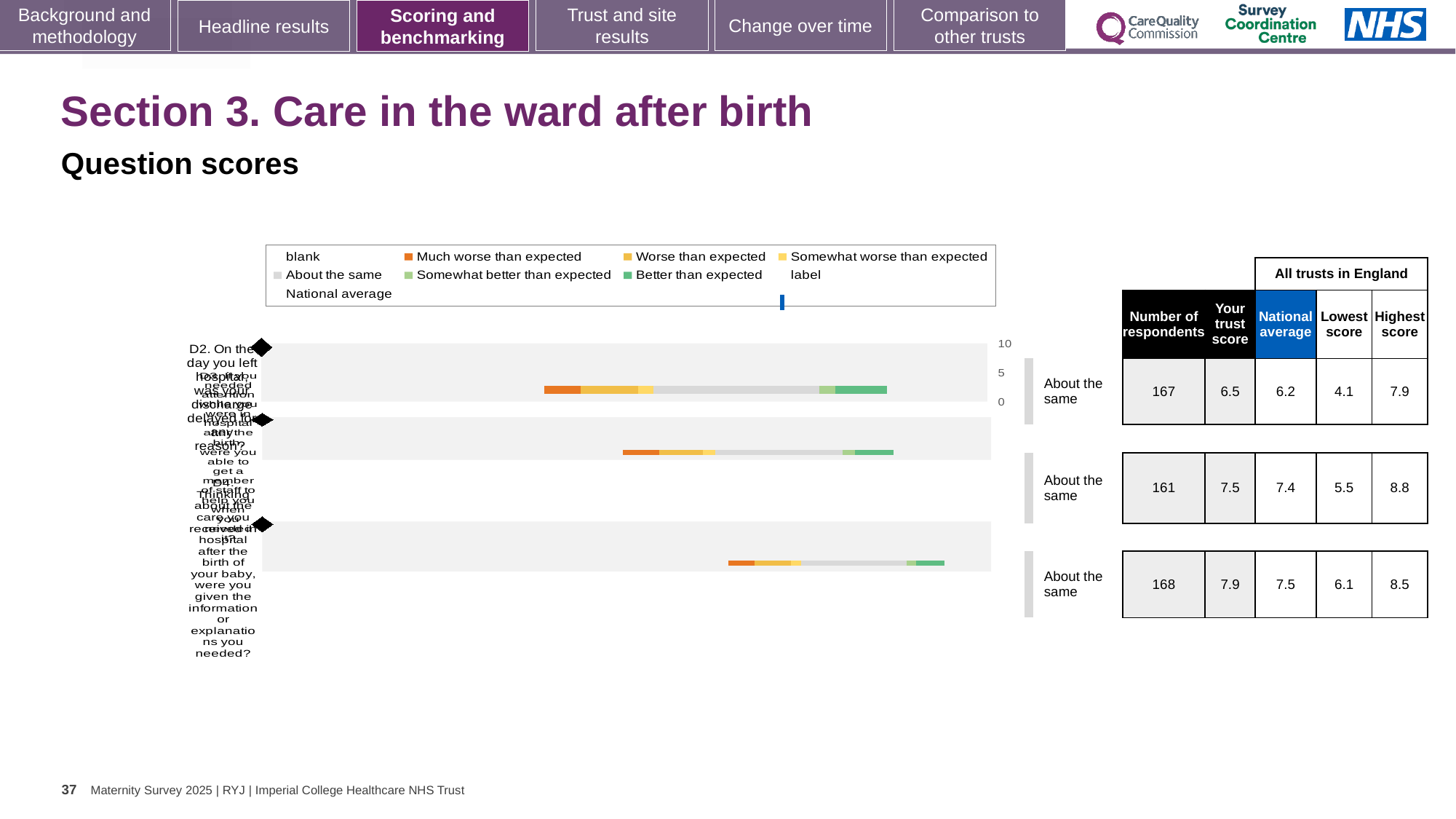
In the table beside the chart, what is the national average for the third (bottom) question? 7.5 In the table beside the chart, what is the difference between the trust score and the national average for the third (bottom) question? 0.4 How many horizontal bars are plotted in the chart? 3 What is the highest value shown on the chart's numeric axis? 10 In the table beside the chart, which question row has the highest 'Highest score' value? the second (middle) row, 8.8 In the table beside the chart, what is the number of respondents for the first (top) question? 167 In the table beside the chart, what is the trust score for the second (middle) question? 7.5 What is the benchmark category shown next to each of the three bars? About the same In the table beside the chart, what is the number of respondents for the third (bottom) question? 168 What kind of chart is shown on the slide? bar chart In the table beside the chart, which question row has the lowest 'Lowest score' value? the first (top) row, 4.1 In the table beside the chart, is the trust score for the first (top) question larger or smaller than its national average? larger